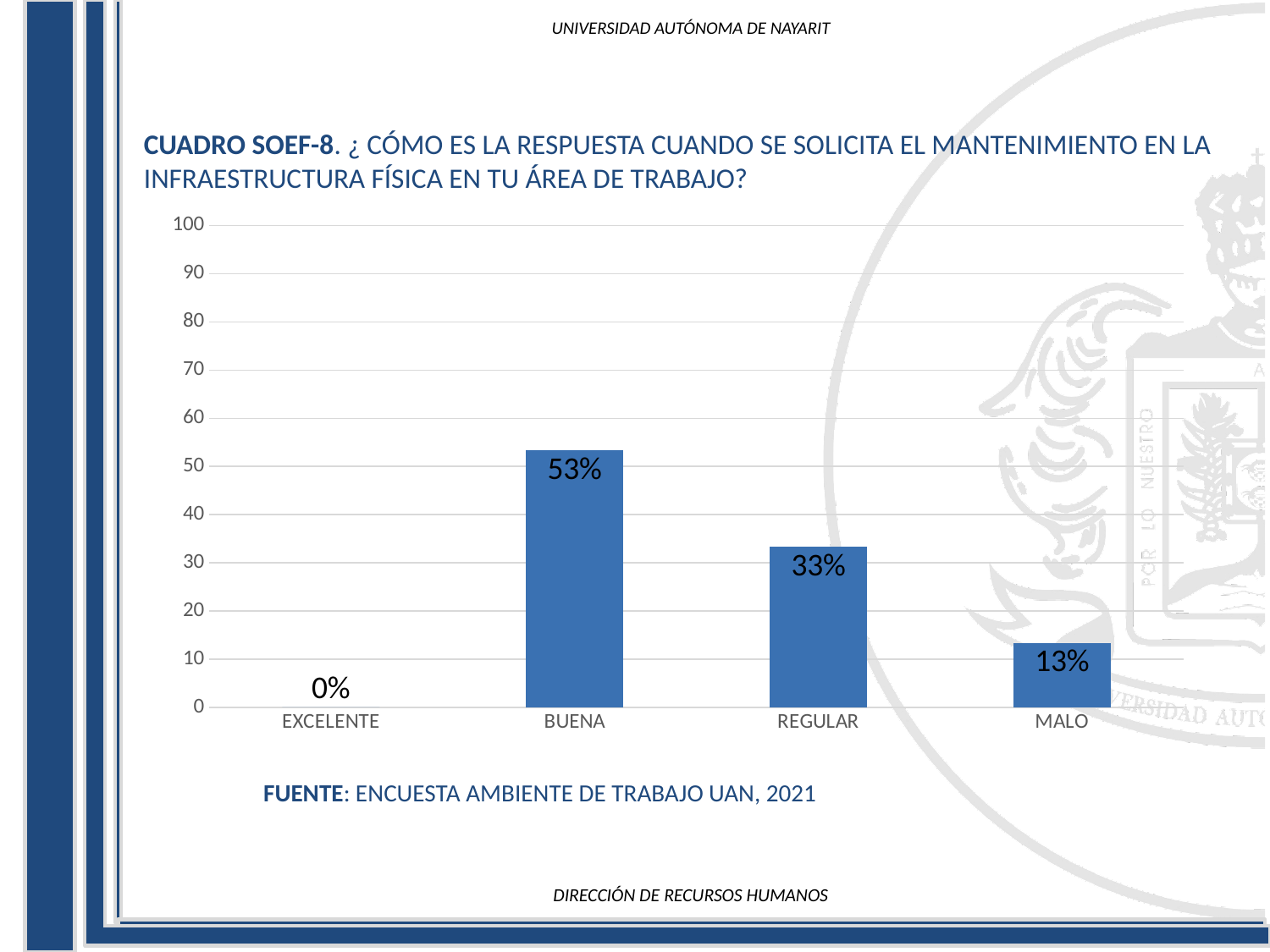
Which category has the lowest value? EXCELENTE What is the difference between the values for REGULAR and MALO? 20% What is the value for REGULAR? 33% Which category has the highest value? BUENA What is the value for BUENA? 53% What kind of chart is shown on the slide? bar chart What is the difference between the values for BUENA and REGULAR? 20% What is the value for EXCELENTE? 0% Is the value for BUENA greater or less than 50? greater How many categories are shown on the x axis? 4 What is the value for MALO? 13% Which is larger, the value for REGULAR or the value for MALO? REGULAR